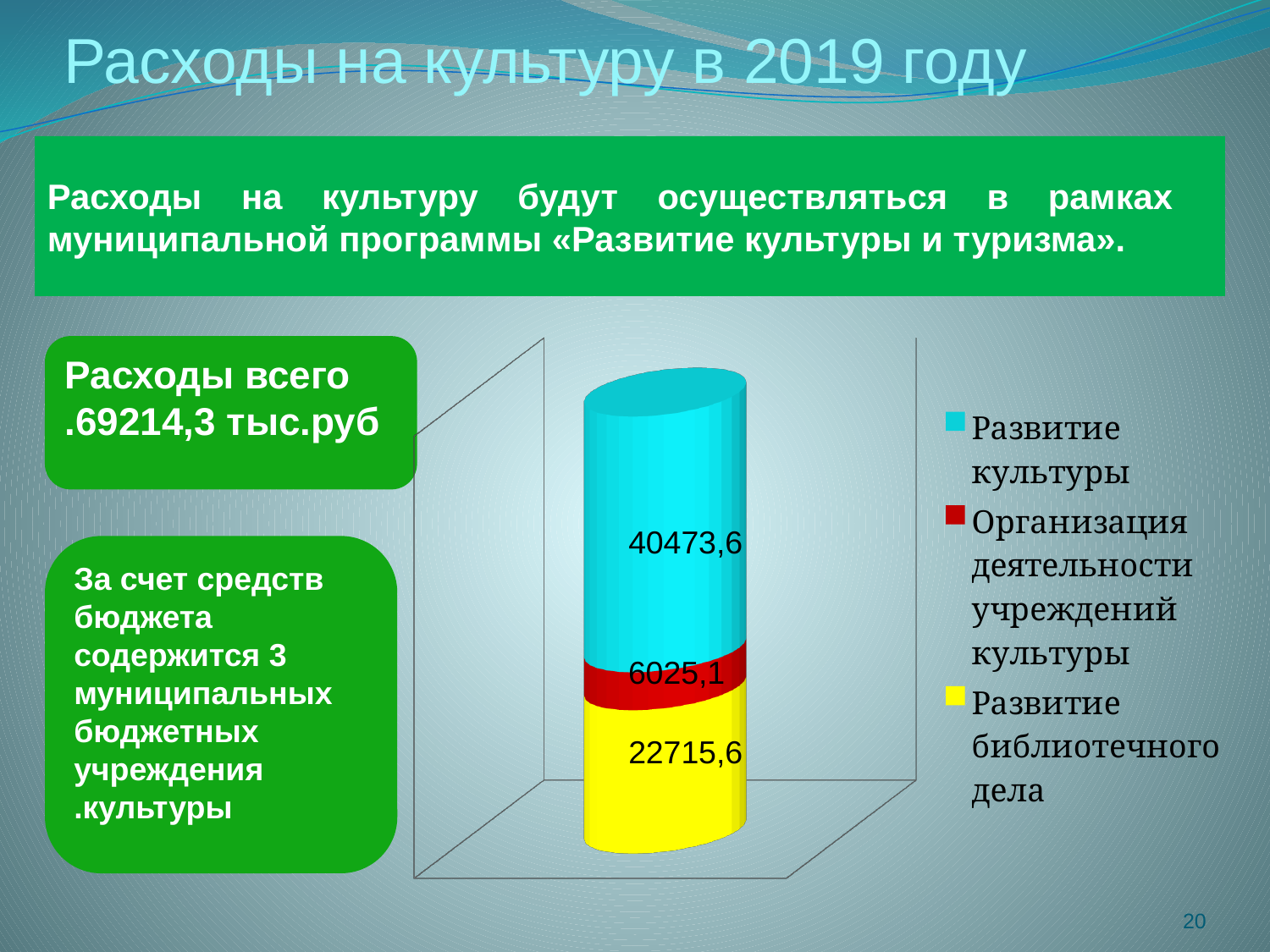
What is the value for «Развитие библиотечного дела»? 22715,6 What is the difference between the values for «Развитие культуры» and «Развитие библиотечного дела»? 17758,0 Which is larger: the value for «Развитие библиотечного дела» or for «Организация деятельности учреждений культуры»? Развитие библиотечного дела Which colour represents «Развитие библиотечного дела» in the chart? Yellow What is the value for «Развитие культуры» in the stacked bar? 40473,6 Which series has the smallest value in the stacked bar? Организация деятельности учреждений культуры What is the total of the stacked bar? 69214,3 What kind of chart is shown on the slide? Stacked bar chart What is the value for «Организация деятельности учреждений культуры»? 6025,1 How many series does the legend list? 3 Which series has the largest value in the stacked bar? Развитие культуры What is the difference between the values for «Развитие библиотечного дела» and «Организация деятельности учреждений культуры»? 16690,5